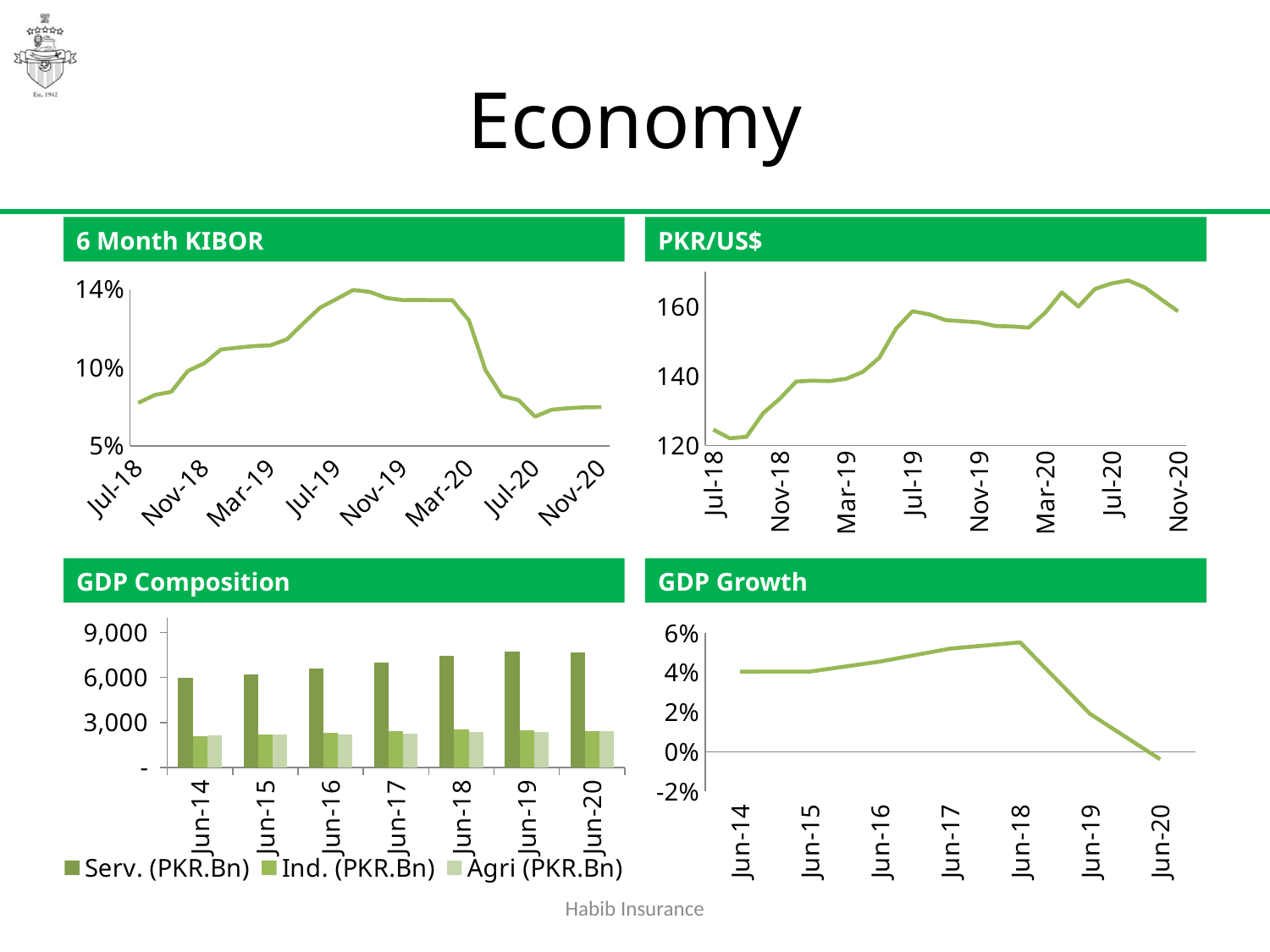
In the PKR/US$ chart, is the value at Jul-18 greater or less than 140? less What kind of chart is the 6 Month KIBOR chart? Line chart In the 6 Month KIBOR chart, is the value at Jul-19 greater or less than 10%? greater In the GDP Composition chart, how many categories are shown on the x axis? 7 In the GDP Growth chart, which period has the lowest value? Jun-20 In the GDP Composition chart, which is larger in Jun-20, Serv. (PKR.Bn) or Agri (PKR.Bn)? Serv. (PKR.Bn) In the GDP Growth chart, which period has the highest value? Jun-18 What kind of chart is the GDP Composition chart? Bar chart In the GDP Growth chart, is the value for Jun-18 greater or less than 4%? greater In the GDP Composition chart, what are the legend entries? Serv. (PKR.Bn), Ind. (PKR.Bn), Agri (PKR.Bn) In the GDP Growth chart, do values rise or fall from Jun-18 to Jun-20? Fall In the GDP Composition chart, how many series does the legend list? 3